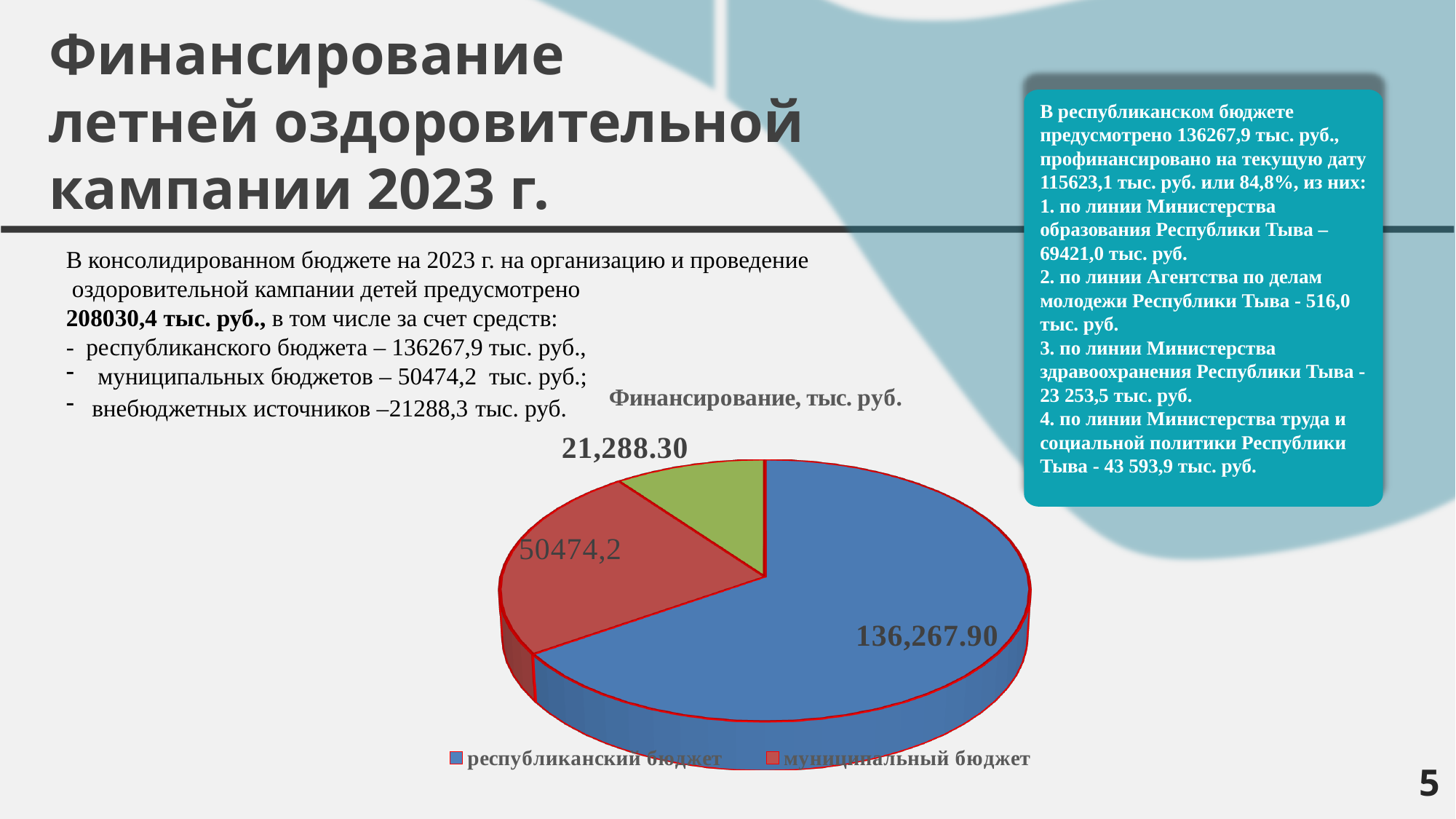
How many slices does the pie chart have? 3 Which slice of the pie chart is the largest? республиканский бюджет What value is shown for муниципальный бюджет in the pie chart? 50474,2 What is the title of the pie chart? Финансирование, тыс. руб. How many entries does the legend of the pie chart list? 2 What is the difference between the республиканский бюджет value and the муниципальный бюджет value in the pie chart? 85,793.70 What value is shown for республиканский бюджет in the pie chart? 136,267.90 What colour is the slice for муниципальный бюджет in the pie chart? red Which is larger in the pie chart: республиканский бюджет or муниципальный бюджет? республиканский бюджет Which slice of the pie chart is the smallest? the green slice (21,288.30) What type of chart is shown on the slide? pie chart What value is labelled on the green slice of the pie chart? 21,288.30